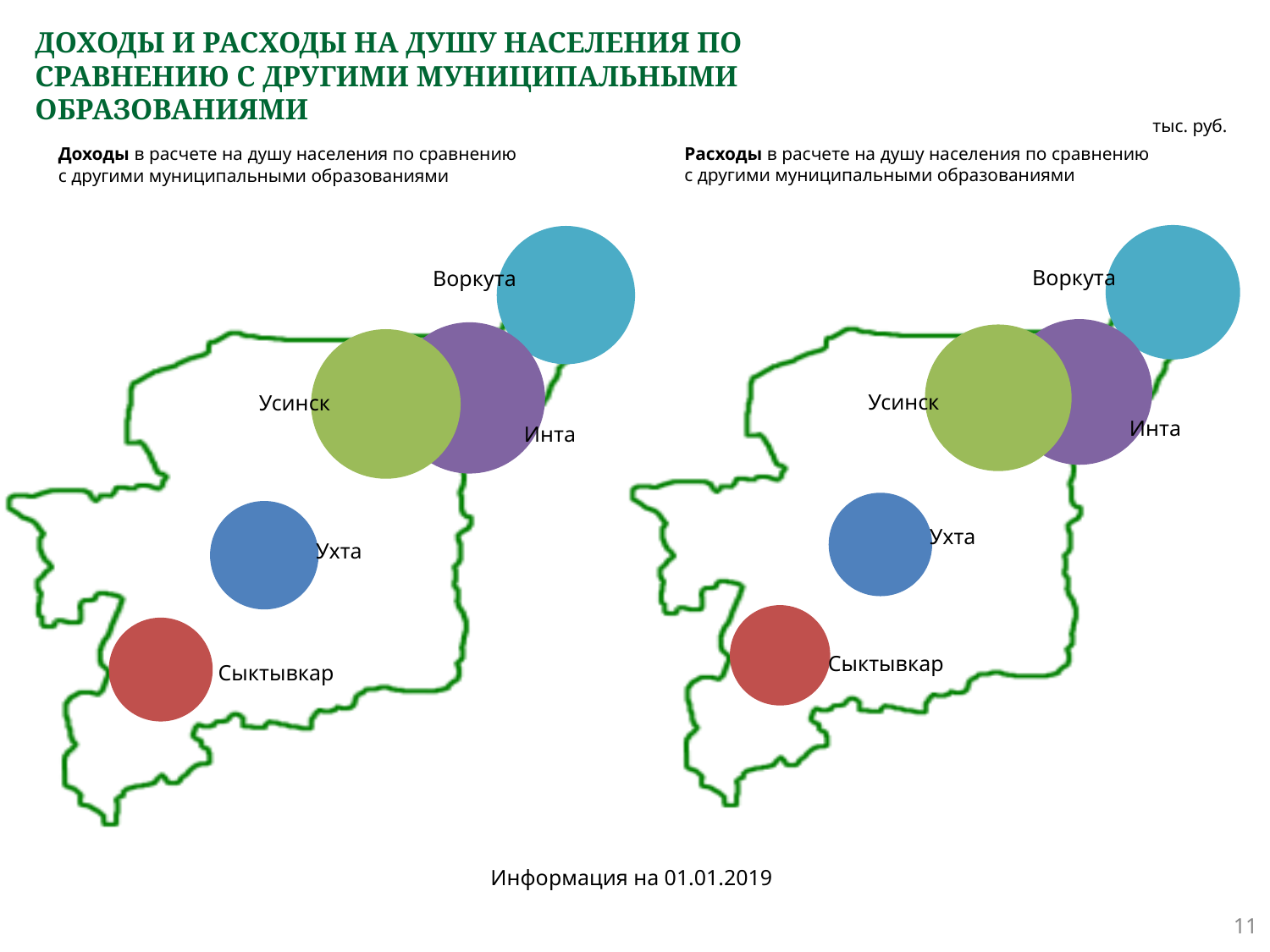
What colour is the bubble for Сыктывкар on the left chart (Доходы)? Red On the right chart (Расходы), which bubble is larger: Усинск or Сыктывкар? Усинск On the left chart (Доходы), which bubble is larger: Усинск or Ухта? Усинск How many municipalities are shown as bubbles on the left chart (Доходы)? 5 Which municipality is represented by the purple bubble on the right chart (Расходы)? Инта On the left chart (Доходы), which bubble is larger: Инта or Ухта? Инта How many municipalities are shown as bubbles on the right chart (Расходы)? 5 What unit of measurement is stated for the charts on the slide? тыс. руб. What kind of chart is used on the left (Доходы) to compare municipalities? Bubble chart